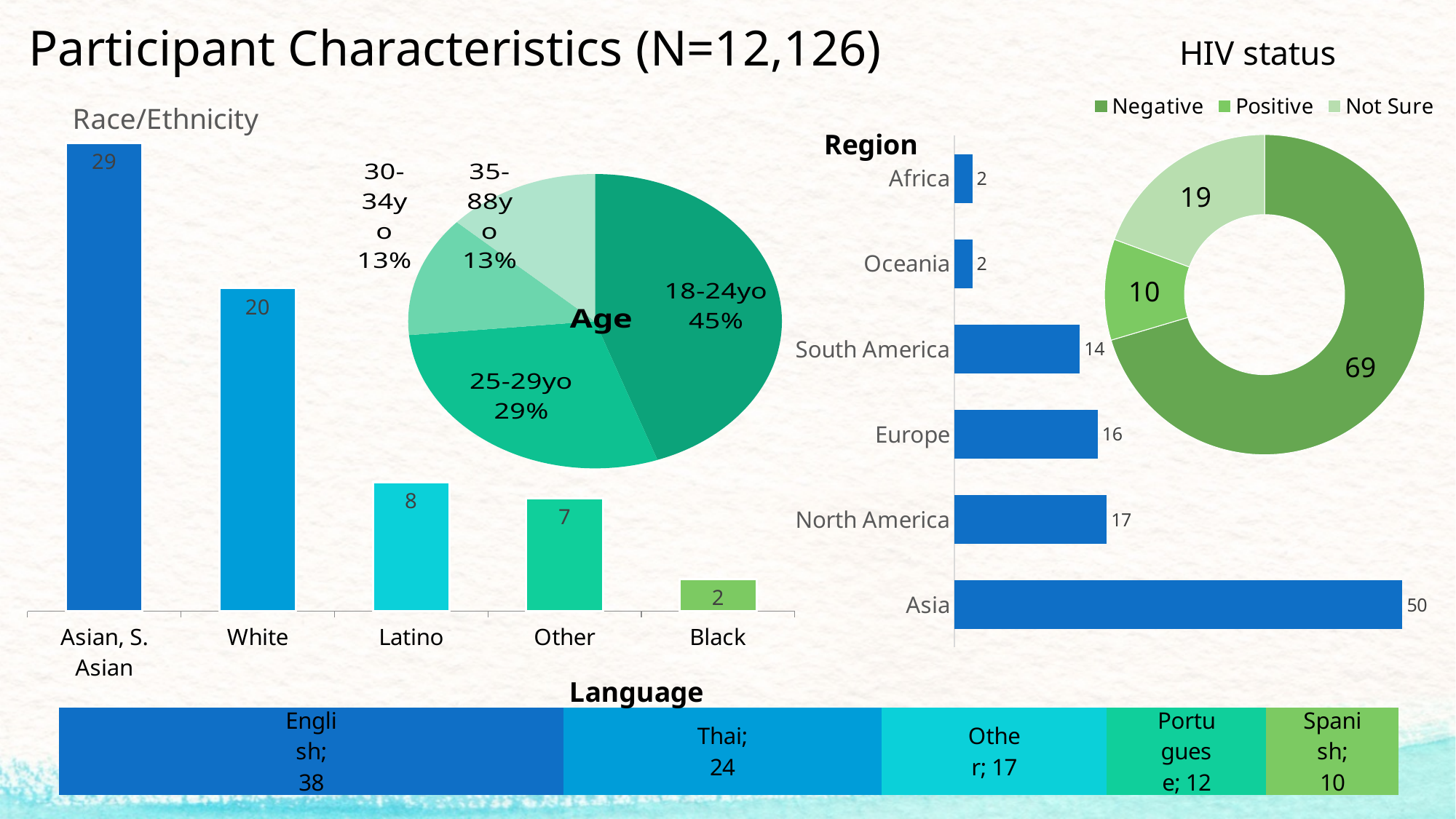
In the Region chart, which is larger, North America or South America? North America How many series does the legend of the HIV status chart list? 3 In the HIV status chart, what is the value for Positive? 10 In the Language chart, what is the value for Thai? 24 In the Race/Ethnicity chart, what is the value for White? 20 In the Age pie chart, what share is the 18-24yo slice? 45% In the Race/Ethnicity chart, which category has the highest value? Asian, S. Asian In the Age pie chart, which age group has the largest share? 18-24yo In the Region chart, which region has the lowest value? Africa and Oceania (both 2) In the Race/Ethnicity chart, what is the difference between the values for Asian, S. Asian and Black? 27 In the Race/Ethnicity chart, how many categories are shown? 5 In the Region chart, what is the value for Europe? 16